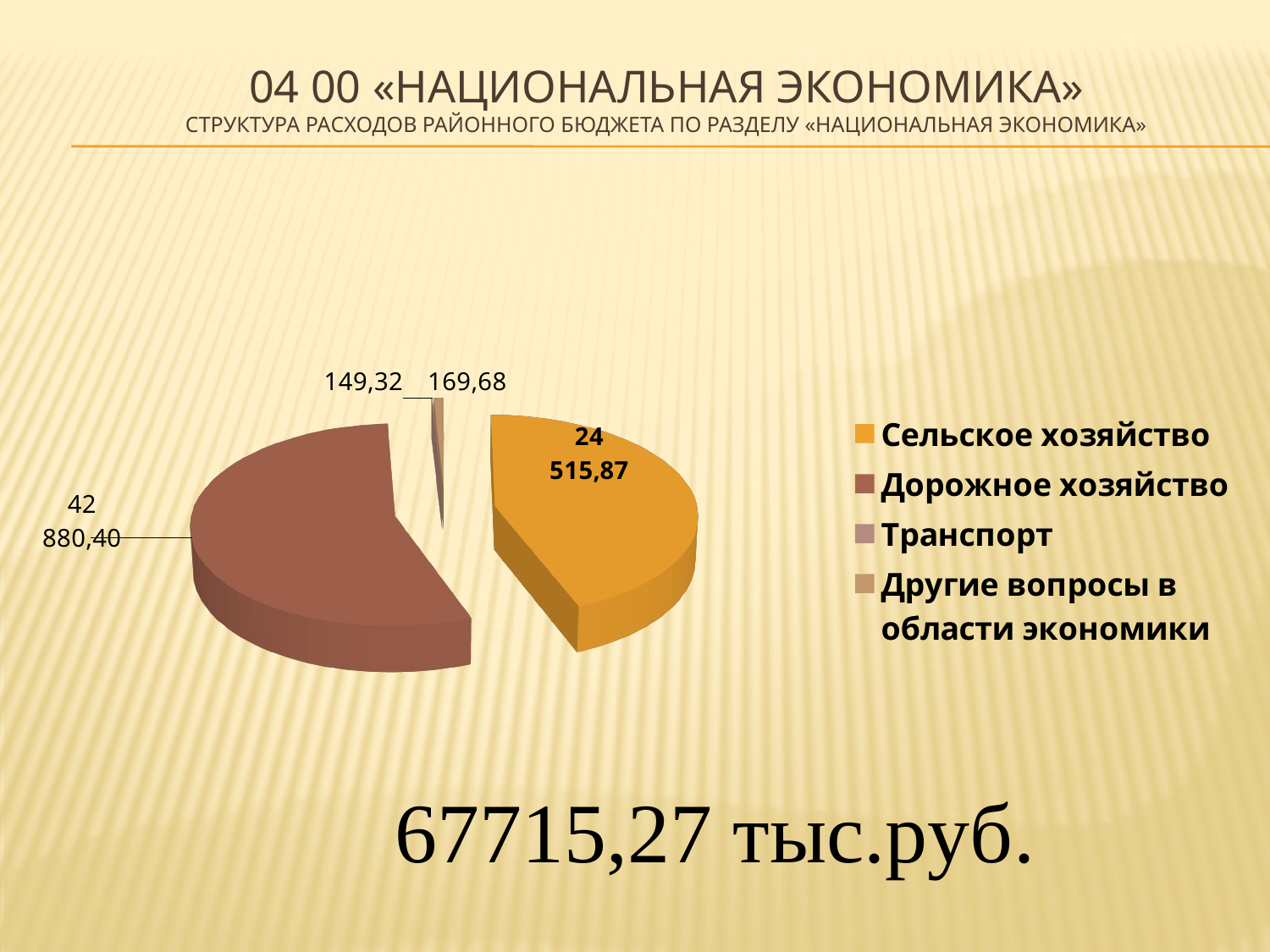
What is the difference between the values for Дорожное хозяйство and Сельское хозяйство? 18 364,53 What is the value for Сельское хозяйство? 24 515,87 What is the value for Другие вопросы в области экономики? 169,68 What total amount is printed below the pie chart? 67715,27 тыс.руб. What is the value for Транспорт? 149,32 What kind of chart is shown on the slide? pie chart Which is larger, the value for Сельское хозяйство or the value for Дорожное хозяйство? Дорожное хозяйство How many slices does the pie chart have? 4 What is the value for Дорожное хозяйство? 42 880,40 Which category has the largest slice of the pie? Дорожное хозяйство Which category has the smallest slice of the pie? Транспорт How many entries does the legend list? 4